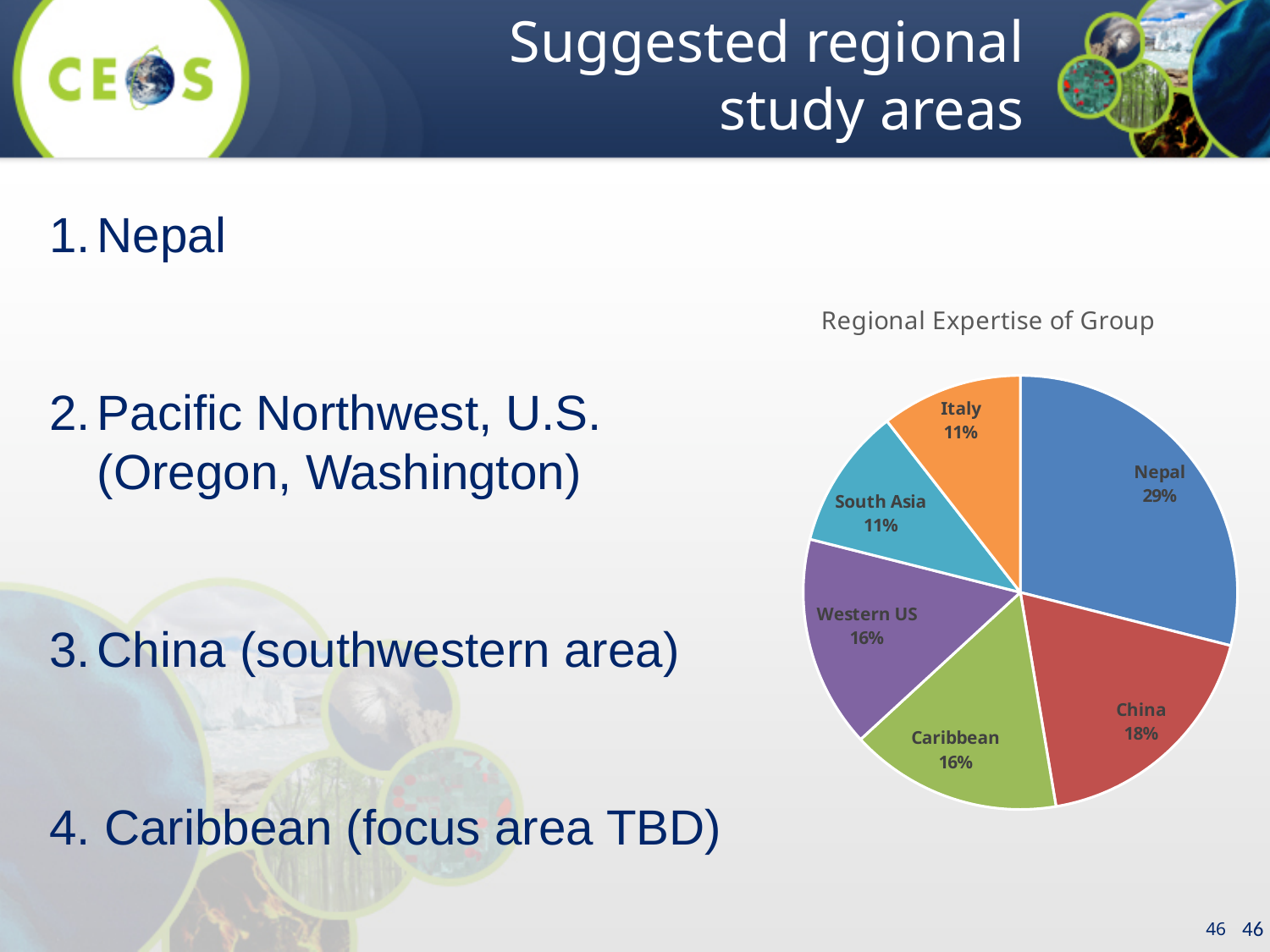
What share of the pie does China represent? 18% Which is larger, the share for Western US or the share for South Asia? Western US What share of the pie does Caribbean represent? 16% How many slices does the pie chart have? 6 What is the title of the chart? Regional Expertise of Group What share of the pie does Nepal represent? 29% What type of chart is shown on the slide? pie chart Which region has the largest slice of the pie? Nepal What is the difference in percentage points between Caribbean and Italy? 5 What is the difference in percentage points between Nepal and China? 11 Which is larger, the share for China or the share for Caribbean? China